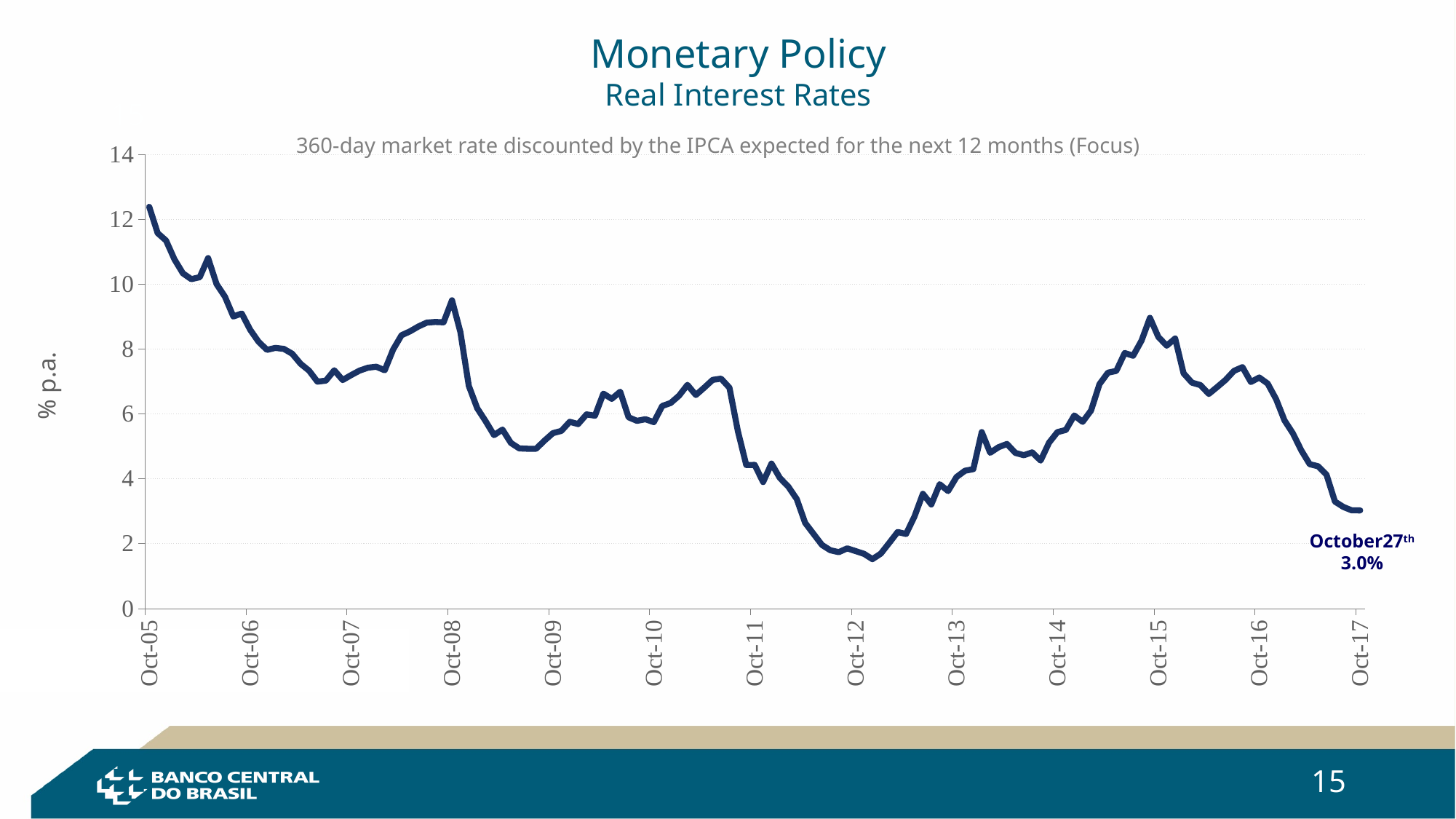
Which x-axis date label has the highest value on the line? Oct-05 Overall, does the real interest rate rise or fall from Oct-05 to Oct-17? fall Is the value at Oct-15 greater or less than 8? greater Which x-axis date label has the lowest value on the line? Oct-12 How many date labels are shown on the x axis? 13 What kind of chart is shown on the slide? line chart Does the line rise or fall between Oct-12 and Oct-15? rise What is the real interest rate value labelled for October 27th? 3.0% Is the value at Oct-08 greater or less than 8? greater Is the value at Oct-12 greater or less than 4? less What is the label on the y axis? % p.a.